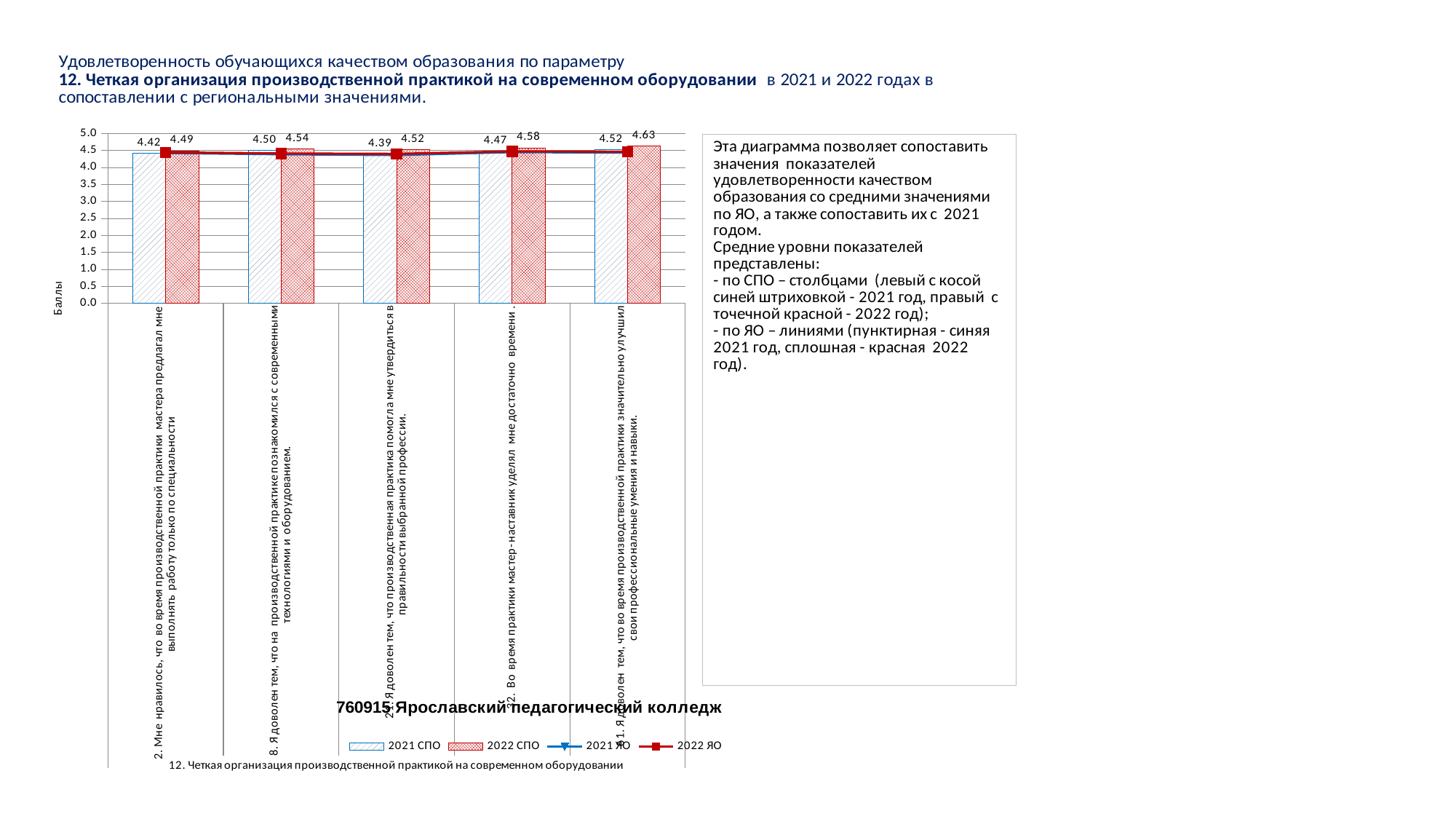
For item 2 (мастера предлагал мне выполнять работу только по специальности), which is larger: the 2021 СПО value or the 2022 СПО value? 2022 СПО Which item has the lowest 2021 СПО value? 21. Я доволен тем, что производственная практика помогла мне утвердиться в правильности выбранной профессии What is the label of the vertical axis of the chart? Баллы What is the 2022 СПО value for item 32 (мастер-наставник уделял мне достаточно времени)? 4.58 How many series does the chart legend list? 4 How many items (categories) are shown on the x axis of the chart? 5 What kind of chart is used to show the СПО values? Bar chart Which item has the highest 2022 СПО value? 61. Я доволен тем, что во время производственной практики значительно улучшил свои профессиональные умения и навыки What is the 2021 СПО value for item 8 (познакомился с современными технологиями и оборудованием)? 4.50